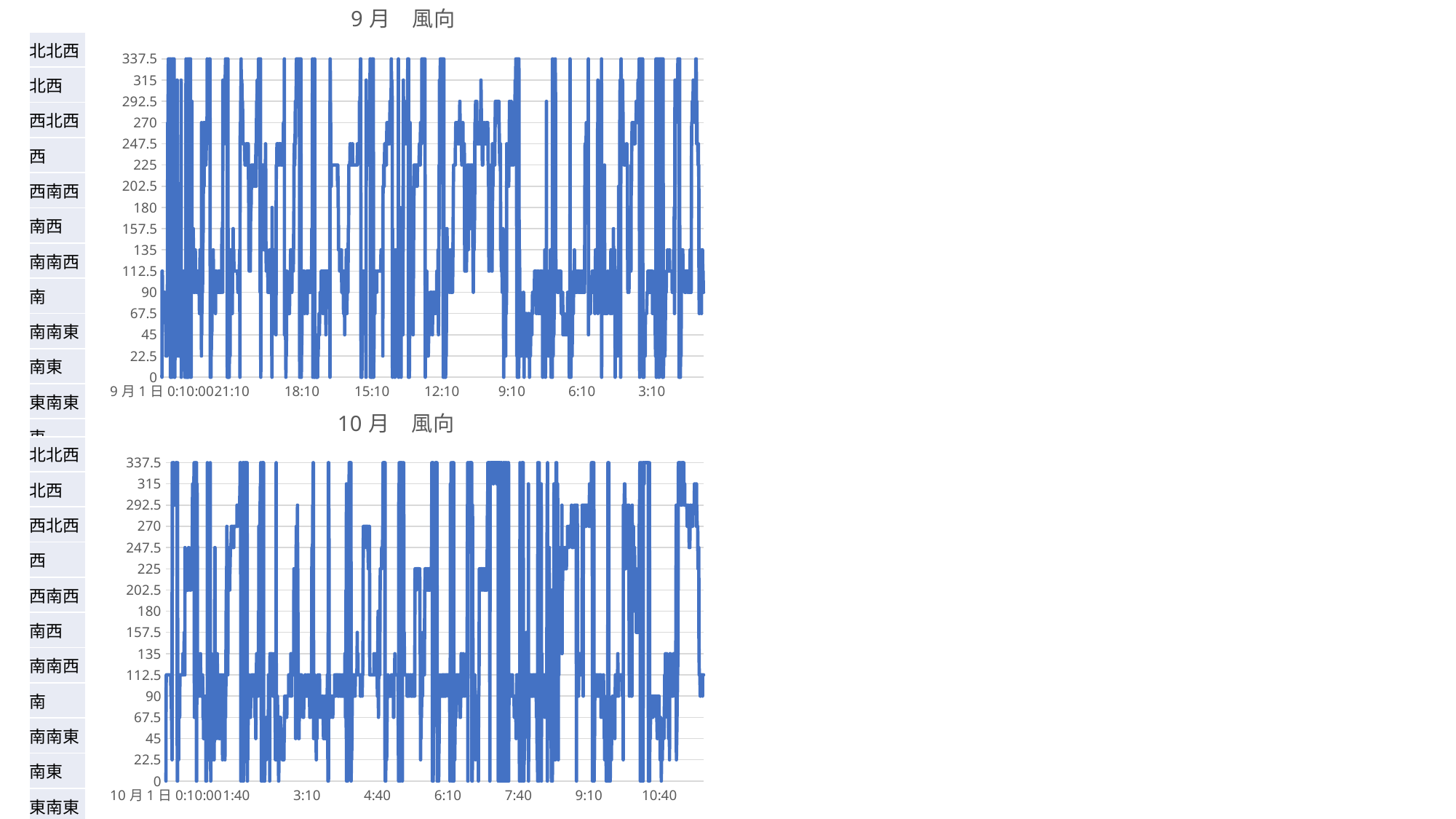
What is the title of the top chart on the slide? 9月 風向 What kind of chart is the "10月 風向" chart at the bottom of the slide? line chart How many charts are shown on the slide? 2 In the "10月 風向" chart, what is the last label on the horizontal axis? 10:40 What is the title of the bottom chart on the slide? 10月 風向 In the "10月 風向" chart, what is the minimum value the line reaches? 0 How many time labels are shown on the horizontal axis of the "10月 風向" chart? 8 In the "9月 風向" chart, what is the first label on the horizontal axis? 9月1日 0:10:00 What kind of chart is the "9月 風向" chart at the top of the slide? line chart In the "10月 風向" chart, what is the interval between consecutive vertical-axis tick labels? 22.5 In the "9月 風向" chart, what is the highest value labelled on the vertical axis? 337.5 In the "9月 風向" chart, what is the maximum value the line reaches? 337.5